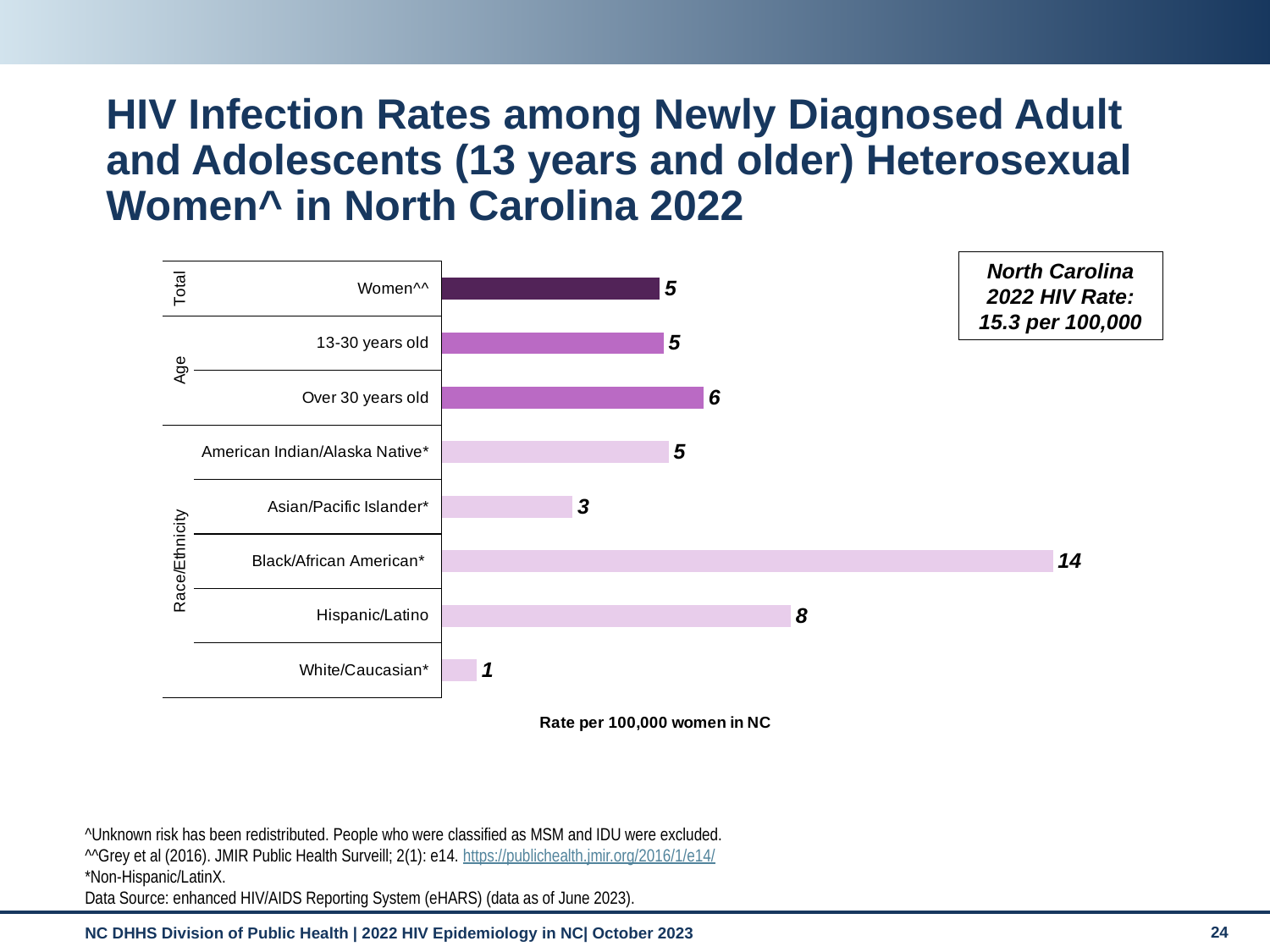
Which is larger, the rate for Asian/Pacific Islander* women or the rate for American Indian/Alaska Native* women? American Indian/Alaska Native* What is the difference between the rates for Black/African American* and Hispanic/Latino women? 6 What is the North Carolina 2022 HIV rate shown in the text box? 15.3 per 100,000 How many categories are plotted in the chart? 8 What kind of chart is shown on the slide? Bar chart What is the HIV infection rate for Black/African American* women? 14 What is the HIV infection rate for Hispanic/Latino women? 8 Which category has the highest HIV infection rate? Black/African American* Which category has the lowest HIV infection rate? White/Caucasian* What is the HIV infection rate for White/Caucasian* women? 1 What is the x-axis label of the chart? Rate per 100,000 women in NC What is the HIV infection rate for women over 30 years old? 6